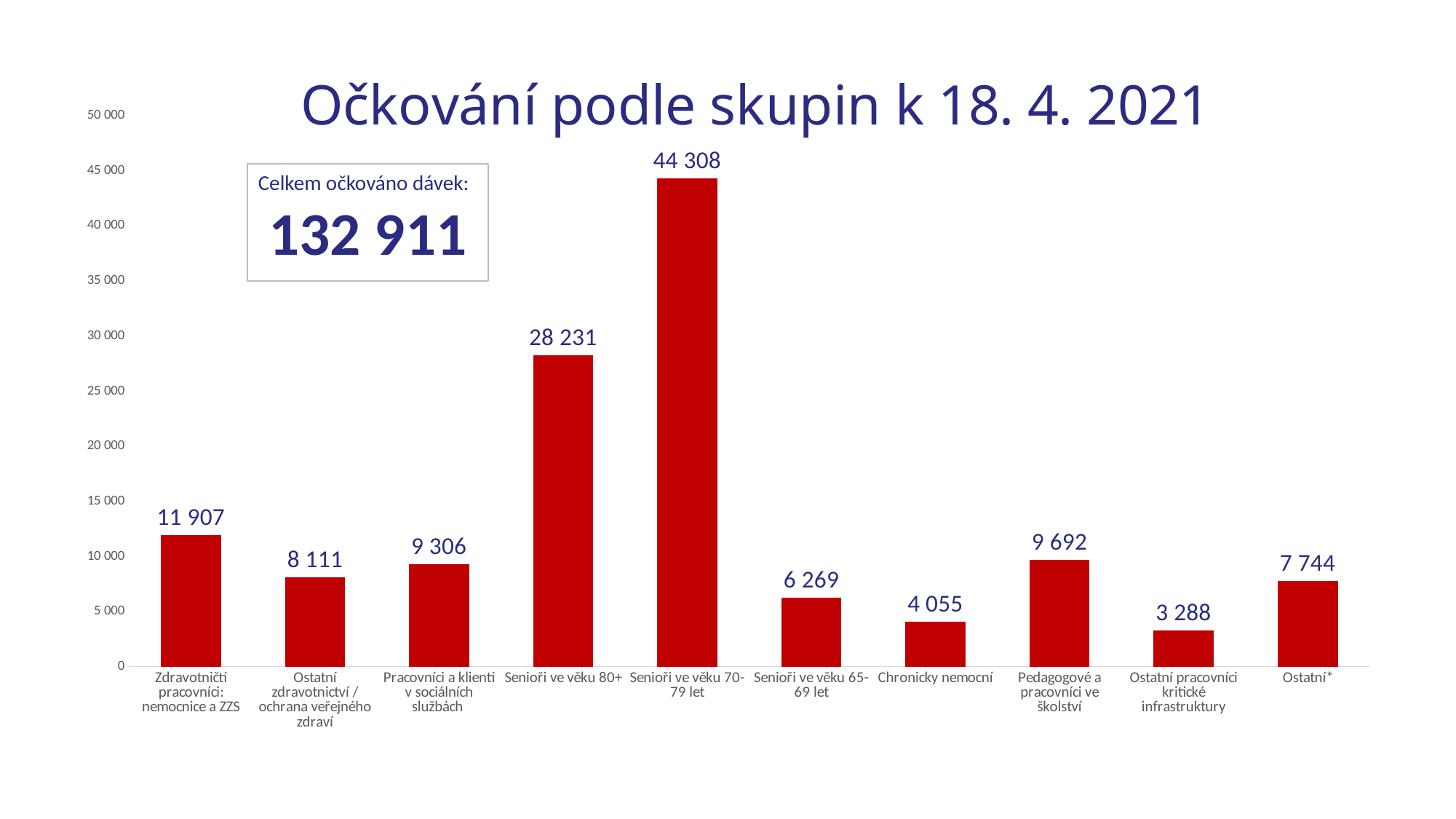
What is the value for Senioři ve věku 70-79 let? 44 308 What is the difference between the values for Senioři ve věku 70-79 let and Senioři ve věku 80+? 16 077 How many categories (bars) does the chart show? 10 What is the value for Pedagogové a pracovníci ve školství? 9 692 Which is larger: the value for Zdravotničtí pracovníci: nemocnice a ZZS or the value for Ostatní zdravotnictví / ochrana veřejného zdraví? Zdravotničtí pracovníci: nemocnice a ZZS What type of chart is shown on the slide? bar chart What is the title of the chart? Očkování podle skupin k 18. 4. 2021 Which category has the lowest value? Ostatní pracovníci kritické infrastruktury What total number of vaccine doses (Celkem očkováno dávek) is shown in the box on the slide? 132 911 Is the value for Senioři ve věku 80+ greater or less than 25 000? greater Which category has the highest value? Senioři ve věku 70-79 let What is the value for Chronicky nemocní? 4 055